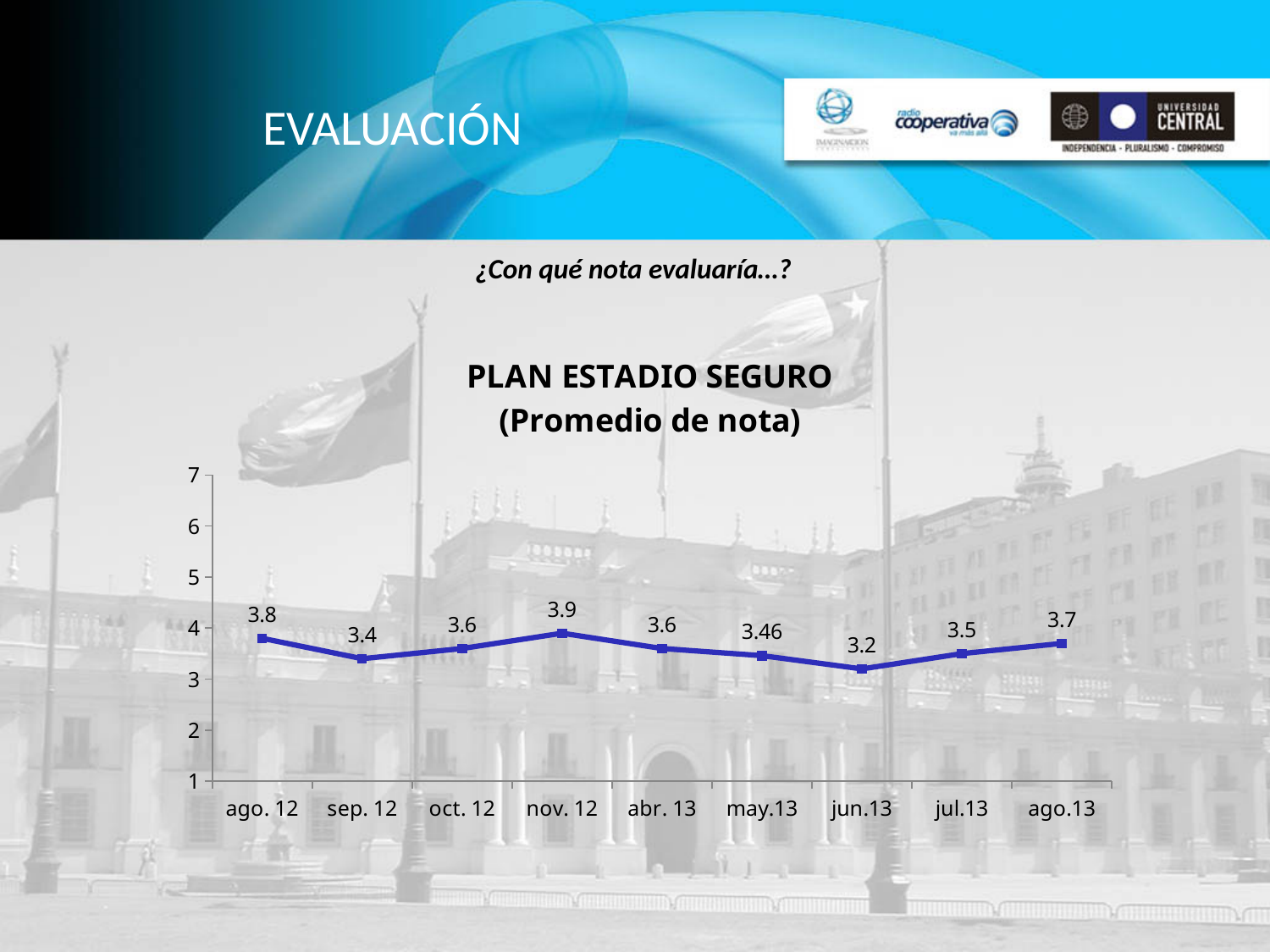
Which month has the highest value? nov. 12 What kind of chart is shown? line chart Is the value for nov. 12 greater or less than 4? less Which is larger, the value for ago. 12 or the value for sep. 12? ago. 12 What is the value for may.13? 3.46 What is the value for nov. 12? 3.9 How many data points are plotted on the chart? 9 What is the value for jun.13? 3.2 What is the value for ago.13? 3.7 What is the difference between the values for nov. 12 and jun.13? 0.7 What is the title of the chart? PLAN ESTADIO SEGURO (Promedio de nota) Which month has the lowest value? jun.13